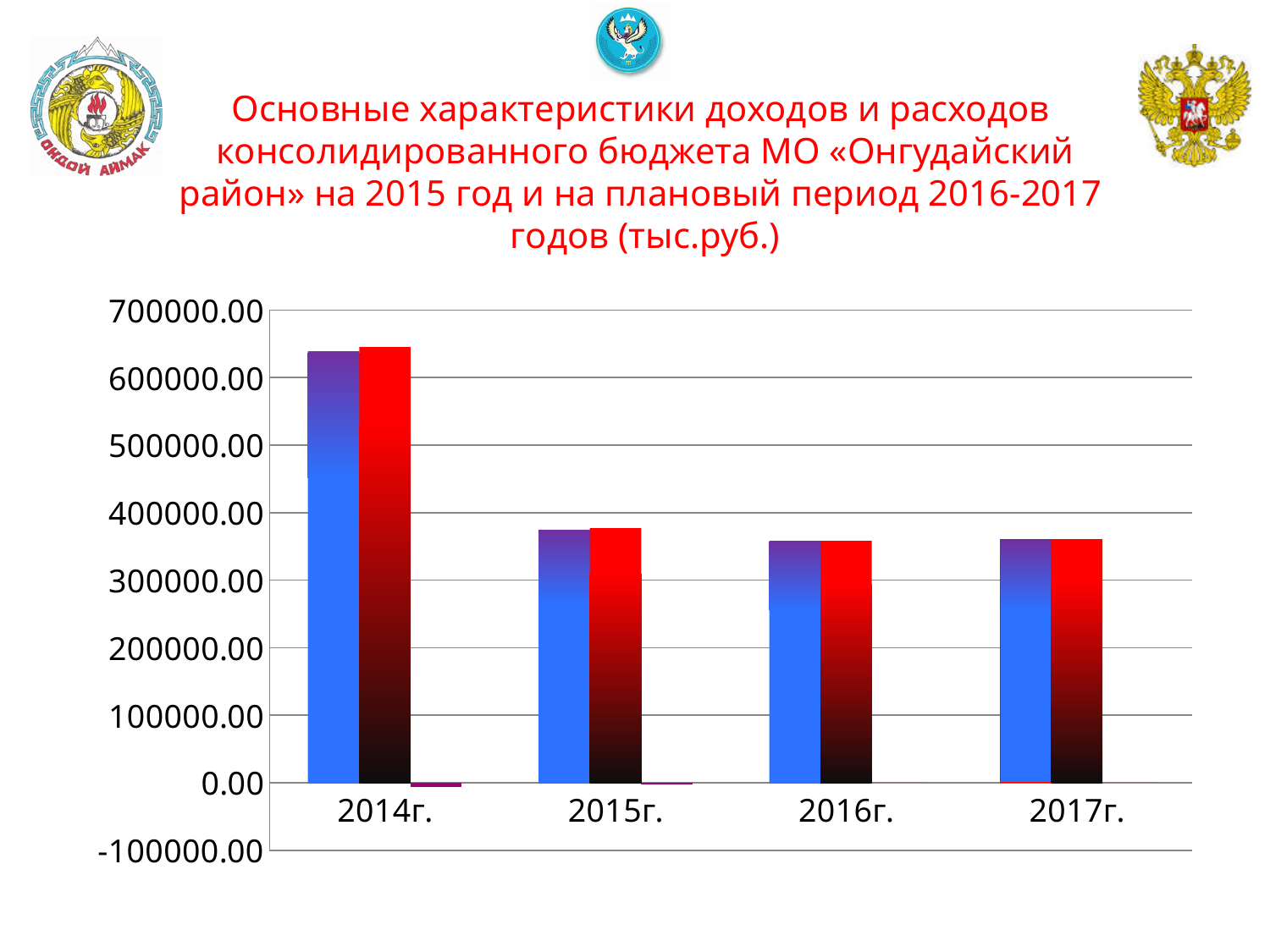
How many year categories are shown on the x axis of the chart? 4 Do the blue bars rise or fall from 2014г. to 2016г.? fall What kind of chart is shown on the slide? bar chart What is the lowest value shown on the vertical axis of the chart? -100000.00 Is the value of the blue bar for 2014г. greater or less than 600000.00? greater Is the value of the red bar for 2015г. greater or less than 400000.00? less Is the value of the blue bar for 2016г. greater or less than 300000.00? greater In which year is the blue bar the tallest? 2014г. What is the highest value shown on the vertical axis of the chart? 700000.00 In which year is the red bar the tallest? 2014г. Which is larger: the blue bar for 2014г. or the blue bar for 2015г.? 2014г.